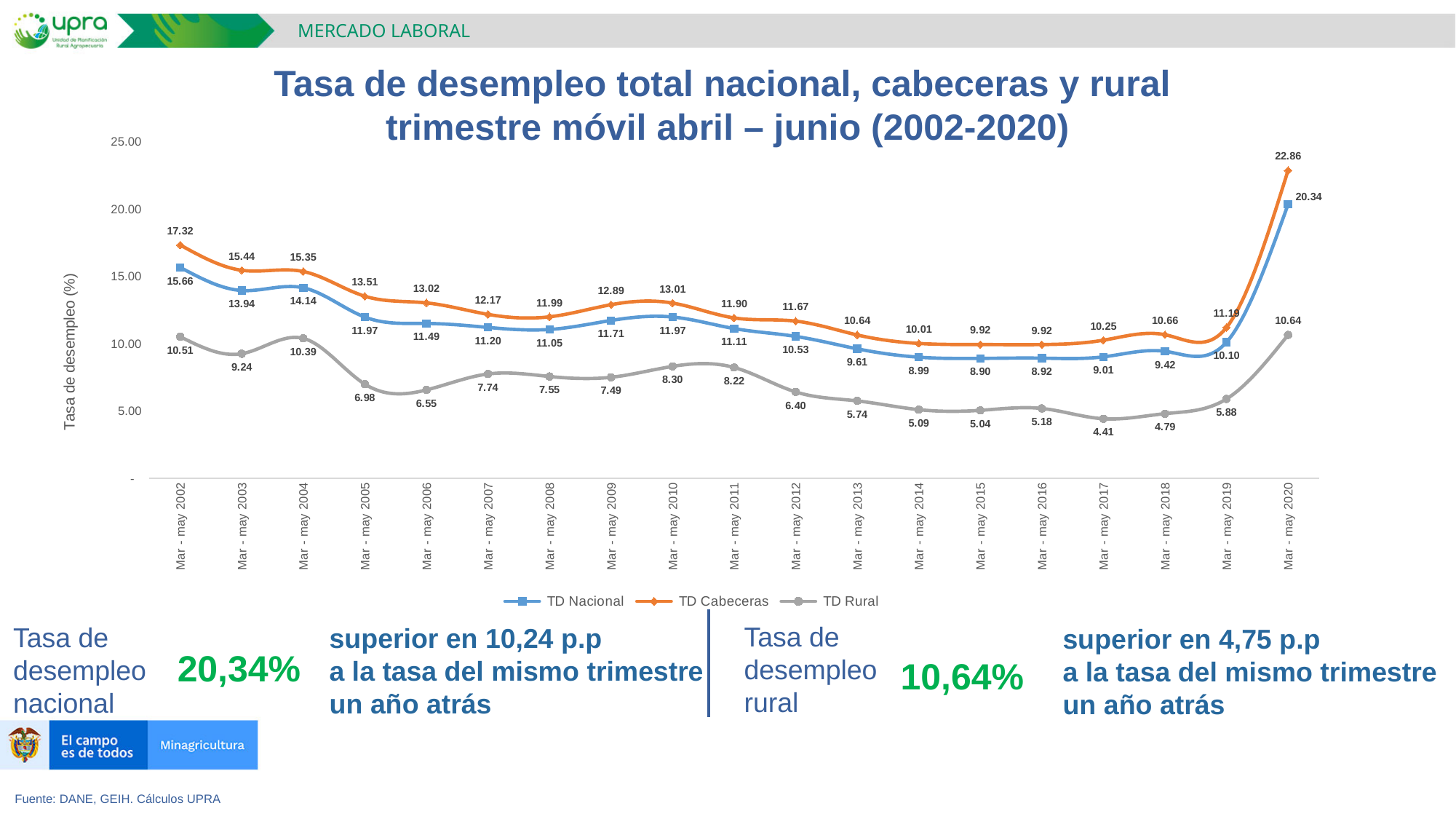
How many series does the legend list? 3 What is the value of TD Cabeceras for Mar - may 2002? 17.32 Which is larger for TD Rural: the value in Mar - may 2002 or in Mar - may 2020? Mar - may 2020 What is the value of TD Nacional for Mar - may 2014? 8.99 What is the difference between TD Cabeceras and TD Nacional in Mar - may 2020? 2.52 In which period does TD Nacional reach its highest value? Mar - may 2020 What kind of chart is shown on the slide? Line chart Does TD Rural rise or fall from Mar - may 2002 to Mar - may 2005? Fall What are the three series named in the legend? TD Nacional, TD Cabeceras, TD Rural In which period does TD Rural reach its lowest value? Mar - may 2017 What is the value of TD Rural for Mar - may 2020? 10.64 How many periods are plotted on the x axis? 19